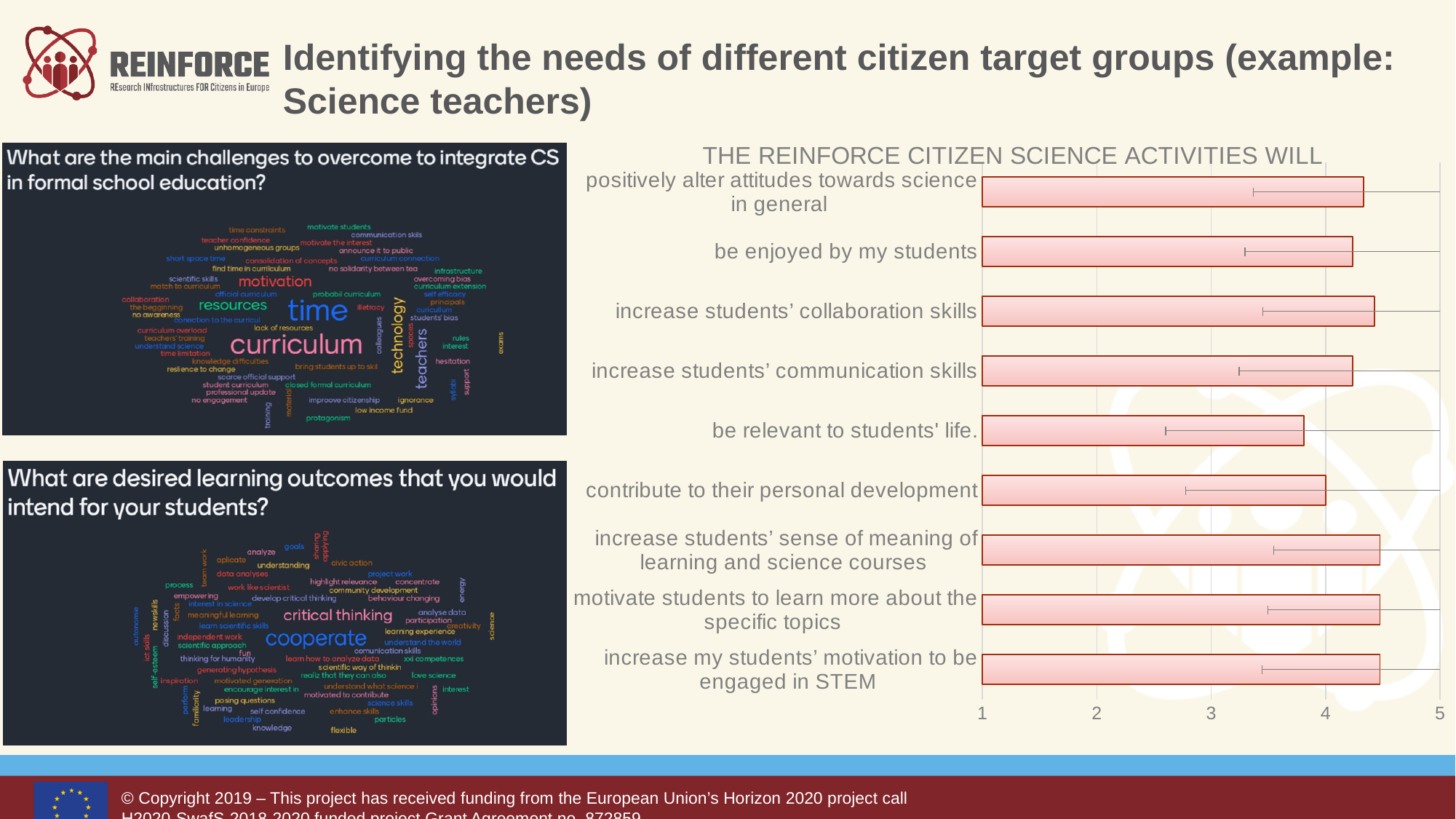
Which has the larger value: 'increase students' collaboration skills' or 'be relevant to students' life.'? increase students' collaboration skills Is the value for 'increase students' collaboration skills' greater or less than 4? greater How many categories does the bar chart show? 9 What kind of chart is shown on the right side of the slide? bar chart Is the value for 'be relevant to students' life.' greater or less than 4? less What is the range of the horizontal axis in the bar chart? 1 to 5 Which category has the lowest value in the bar chart? be relevant to students' life. Is the value for 'be enjoyed by my students' greater or less than 3? greater What is the title of the bar chart? THE REINFORCE CITIZEN SCIENCE ACTIVITIES WILL Which has the larger value: 'be relevant to students' life.' or 'contribute to their personal development'? contribute to their personal development